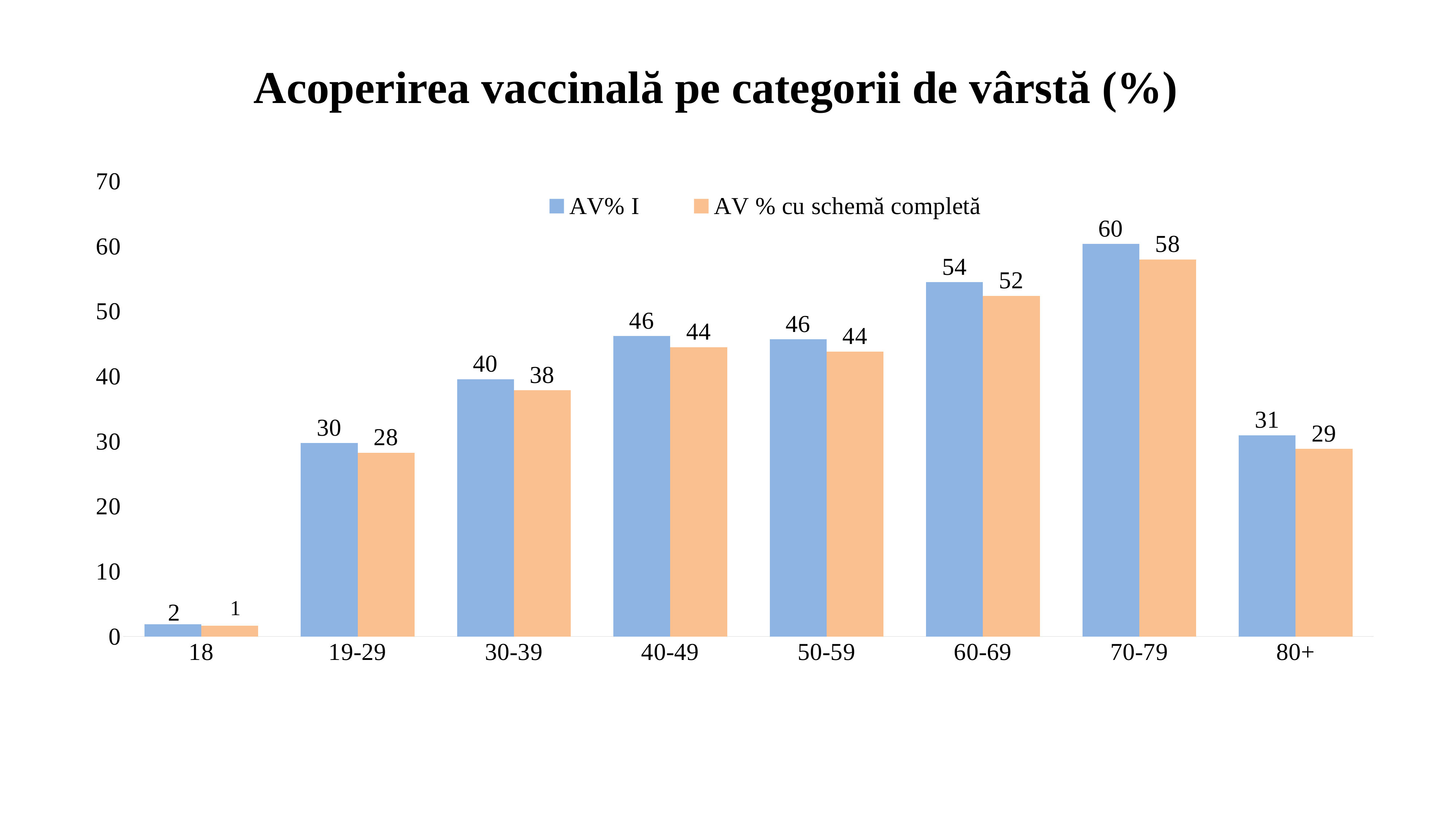
How many series does the legend list? 2 Which age group has the lowest AV % cu schemă completă value? 18 Is the AV% I value for the 40-49 age group greater or less than 40? greater What kind of chart is shown on the slide? bar chart How many age groups are shown on the x axis? 8 What is the AV % cu schemă completă value for the 19-29 age group? 28 Which age group has the highest AV% I value? 70-79 What is the title of the chart? Acoperirea vaccinală pe categorii de vârstă (%) What is the AV% I value for the 80+ age group? 31 Which is larger for the 30-39 age group: AV% I or AV % cu schemă completă? AV% I What is the AV% I value for the 70-79 age group? 60 What is the difference between AV% I and AV % cu schemă completă for the 60-69 age group? 2